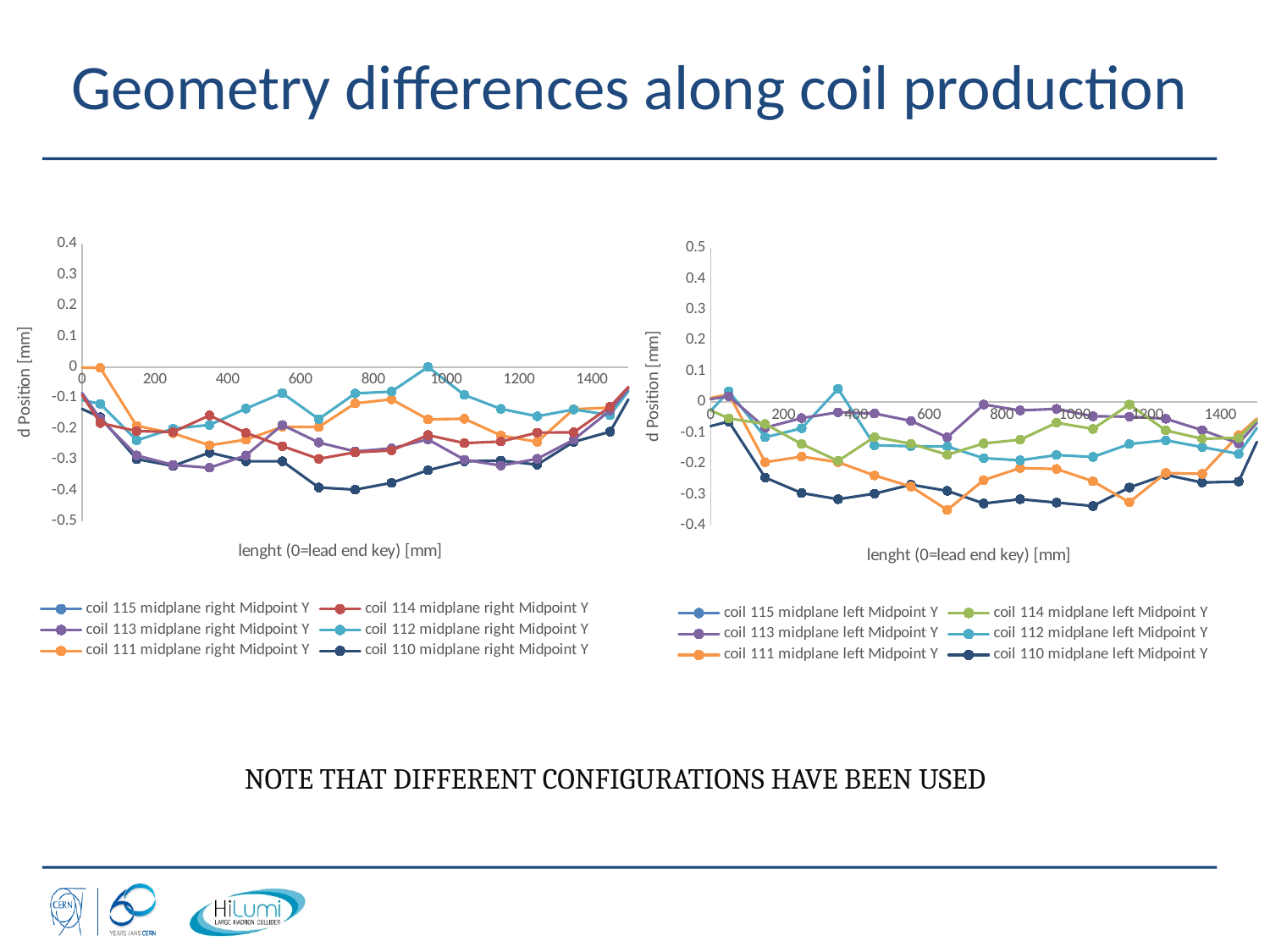
In the right chart, is the value for coil 110 midplane left Midpoint Y at about 1000 mm greater or less than -0.2? less How many series does the legend of the left chart list? 6 What is the y-axis title of the right chart? d Position [mm] What kind of chart is the left chart on the slide? line chart How many series does the legend of the right chart list? 6 In the left chart, is the value for coil 110 midplane right Midpoint Y at about 800 mm greater or less than -0.3? less How many charts are shown on the slide? 2 In the left chart, which series reaches the lowest value? coil 110 midplane right Midpoint Y In the left chart at about 800 mm, which is larger: coil 112 midplane right Midpoint Y or coil 110 midplane right Midpoint Y? coil 112 midplane right Midpoint Y What is the x-axis title of the left chart? lenght (0=lead end key) [mm] In the left chart, is the value for coil 112 midplane right Midpoint Y at about 950 mm greater or less than -0.1? greater